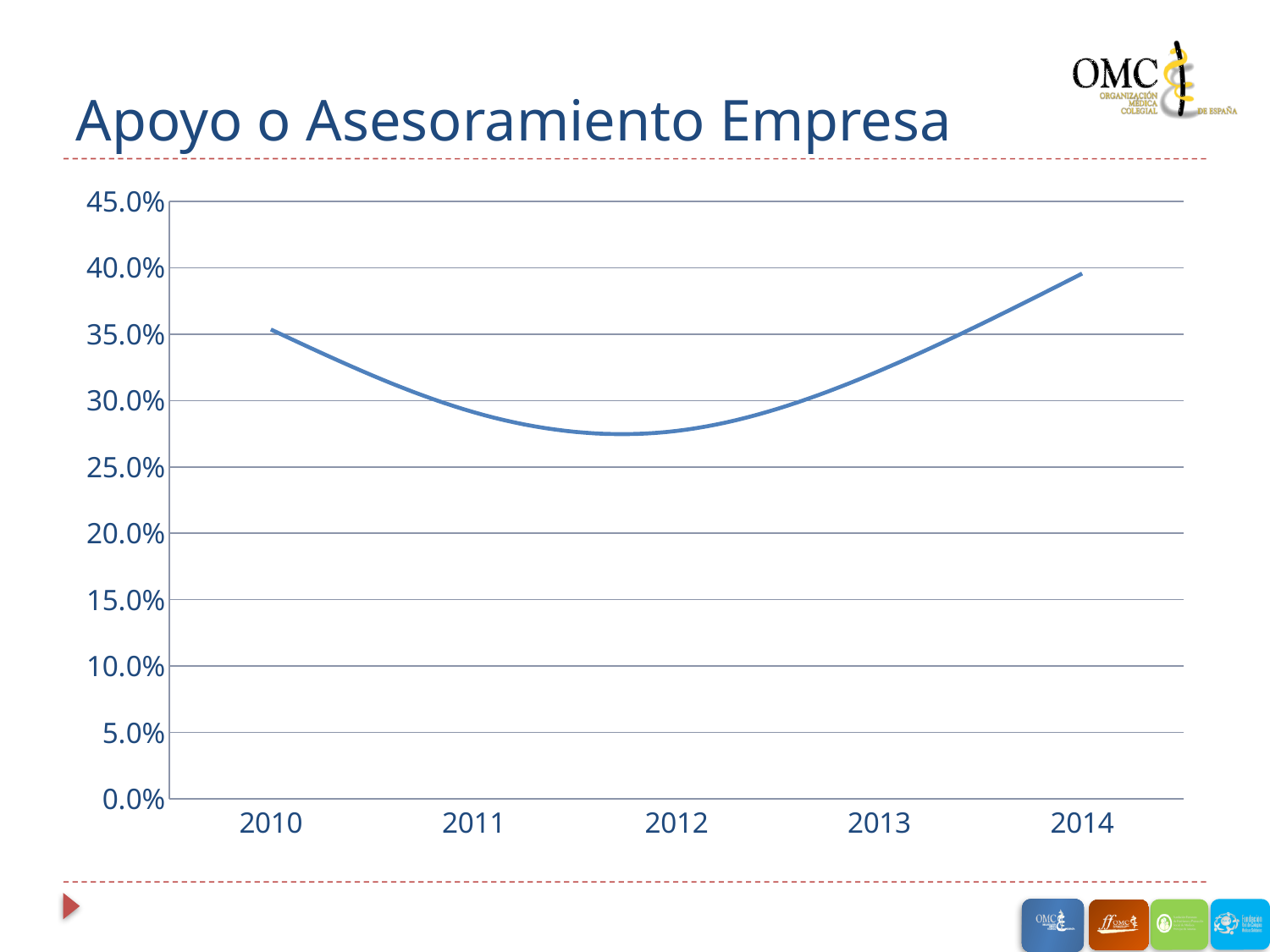
How does the value change from 2010 to 2014 along the x axis? It falls until 2012, then rises Is the value for 2010 greater or less than 30.0%? greater Is the value for 2014 greater or less than 35.0%? greater Which year has the highest value? 2014 Is the value for 2012 greater or less than 30.0%? less Which year has the larger value, 2010 or 2014? 2014 Which year has the lowest value? 2012 What kind of chart is shown on the slide? line chart How many years are plotted on the x axis? 5 What is the title of the chart? Apoyo o Asesoramiento Empresa